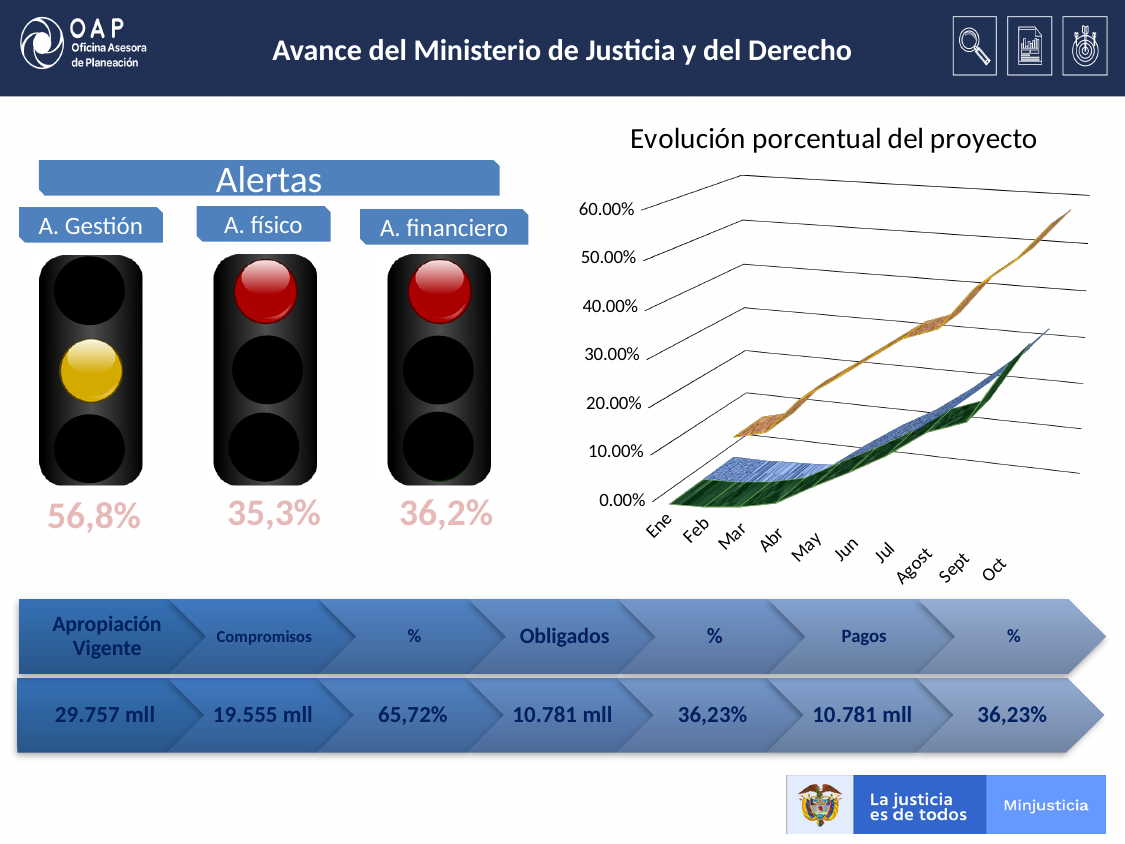
In the 'Evolución porcentual del proyecto' chart, do the values rise or fall from Ene to Oct? rise In the 'Evolución porcentual del proyecto' chart, which month has the highest values? Oct How many months are shown on the x axis of the 'Evolución porcentual del proyecto' chart? 10 What is the lowest tick value shown on the vertical axis of the 'Evolución porcentual del proyecto' chart? 0.00% What is the first month shown on the x axis of the 'Evolución porcentual del proyecto' chart? Ene In the 'Evolución porcentual del proyecto' chart, which month has the lowest values? Ene What is the highest tick value shown on the vertical axis of the 'Evolución porcentual del proyecto' chart? 60.00% What is the title of the chart on the right side of the slide? Evolución porcentual del proyecto What is the last month shown on the x axis of the 'Evolución porcentual del proyecto' chart? Oct What kind of chart is 'Evolución porcentual del proyecto'? 3D line chart